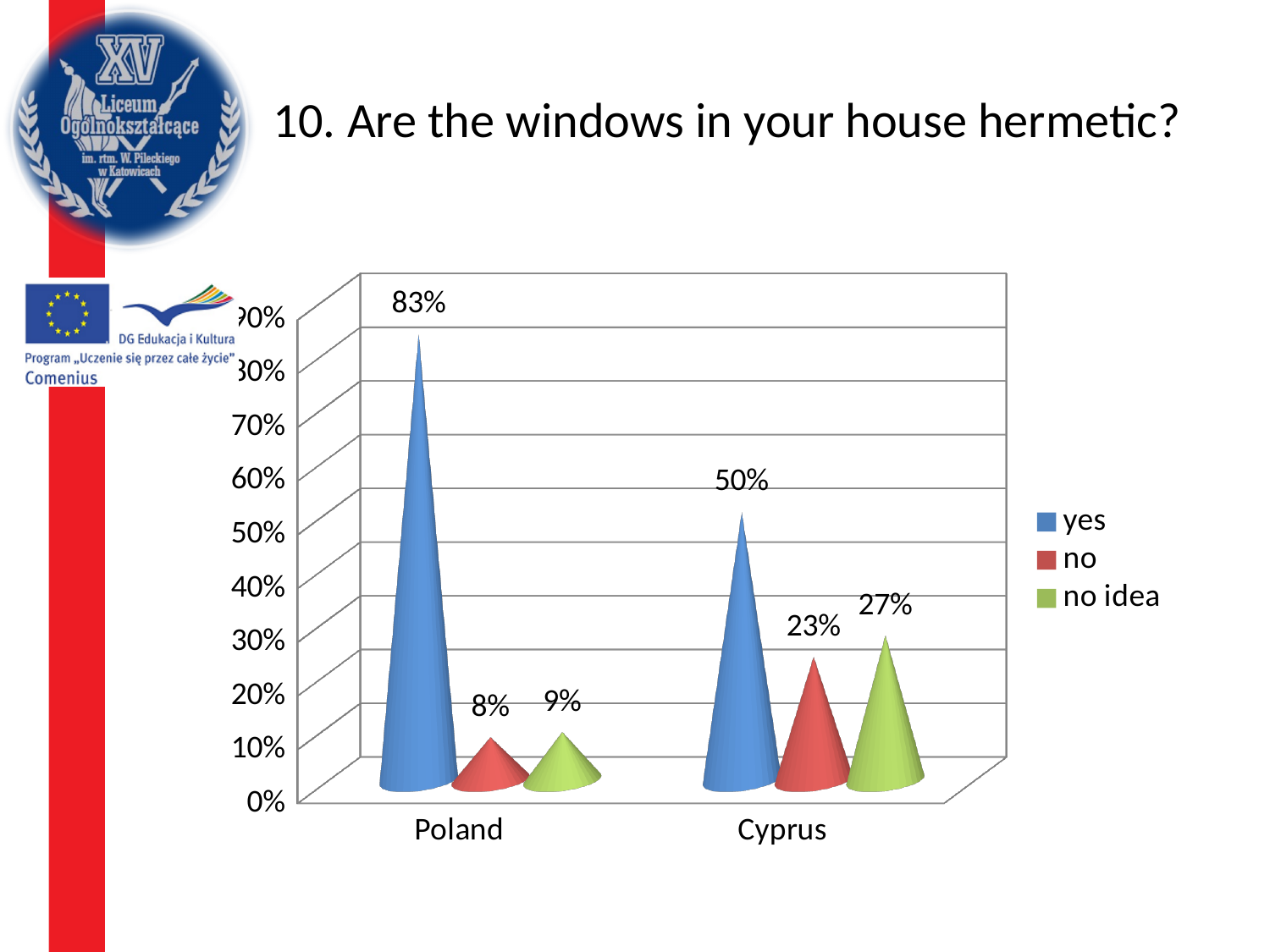
Which country has the higher "yes" value? Poland What is the difference between the "yes" values for Poland and Cyprus? 33% What percentage of respondents in Cyprus answered "no"? 23% What is the difference between the "no idea" values for Cyprus and Poland? 18% How many series does the legend list? 3 What percentage of respondents in Poland answered "no"? 8% What percentage of respondents in Cyprus answered "no idea"? 27% How many countries are shown on the x axis? 2 What percentage of respondents in Poland answered "yes"? 83% What is the title of the slide containing the chart? 10. Are the windows in your house hermetic? Which answer has the lowest value for Poland? no Which answer has the highest value for Cyprus? yes